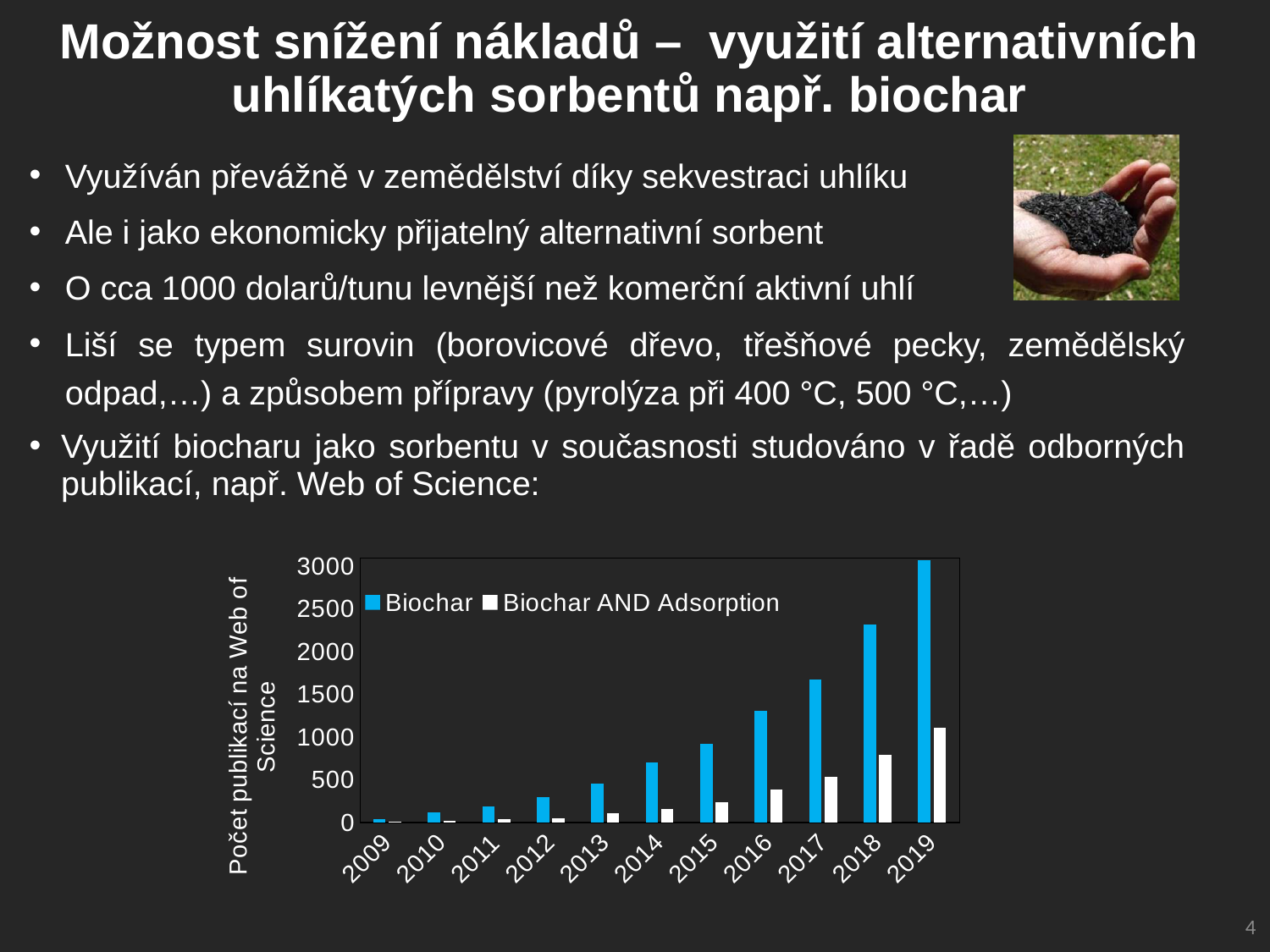
Is the Biochar AND Adsorption value for 2016 greater or less than 500? less In which year is the Biochar series lowest? 2009 How many years are shown on the x axis of the chart? 11 In which year is the Biochar series highest? 2019 Is the Biochar AND Adsorption value for 2019 greater or less than 1000? greater In 2019, which is larger: the Biochar value or the Biochar AND Adsorption value? Biochar Is the Biochar value for 2018 greater or less than 2000? greater Do the Biochar values rise or fall from 2009 to 2019? rise What is the title of the chart's vertical axis? Počet publikací na Web of Science What kind of chart is shown on the slide? bar chart How many series does the chart's legend list? 2